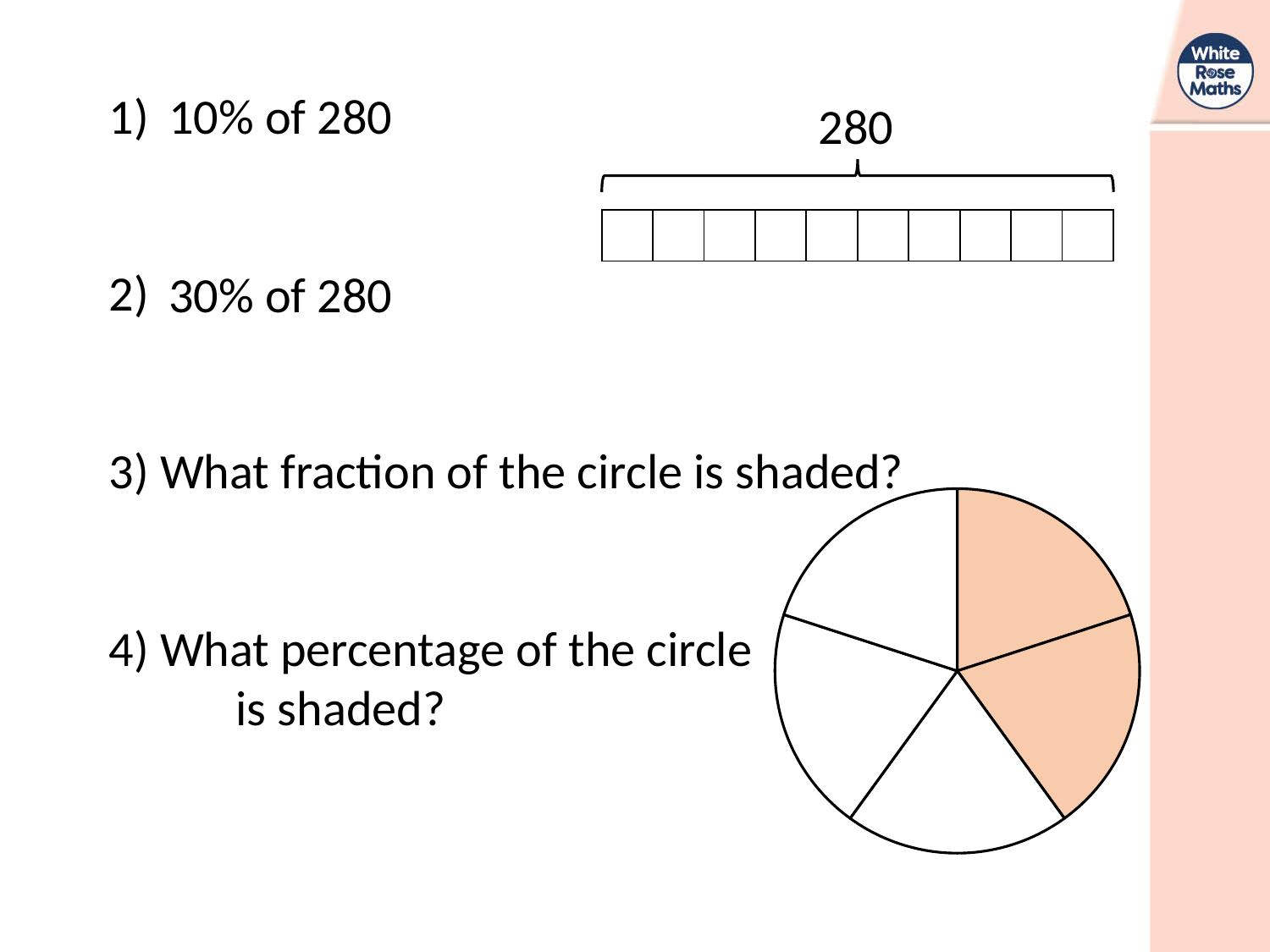
Are more sectors of the circle shaded or unshaded? unshaded How many equal boxes does the bar model at the top of the slide contain? 10 What number is written above the bar model at the top of the slide? 280 How many sectors of the circle at the bottom of the slide are shaded? 2 What fraction of the circle at the bottom of the slide is shaded? 2/5 How many equal sectors is the circle at the bottom of the slide divided into? 5 What percentage of the circle at the bottom of the slide is shaded? 40% What colour are the shaded sectors of the circle? orange Are any of the boxes in the bar model at the top of the slide shaded? No